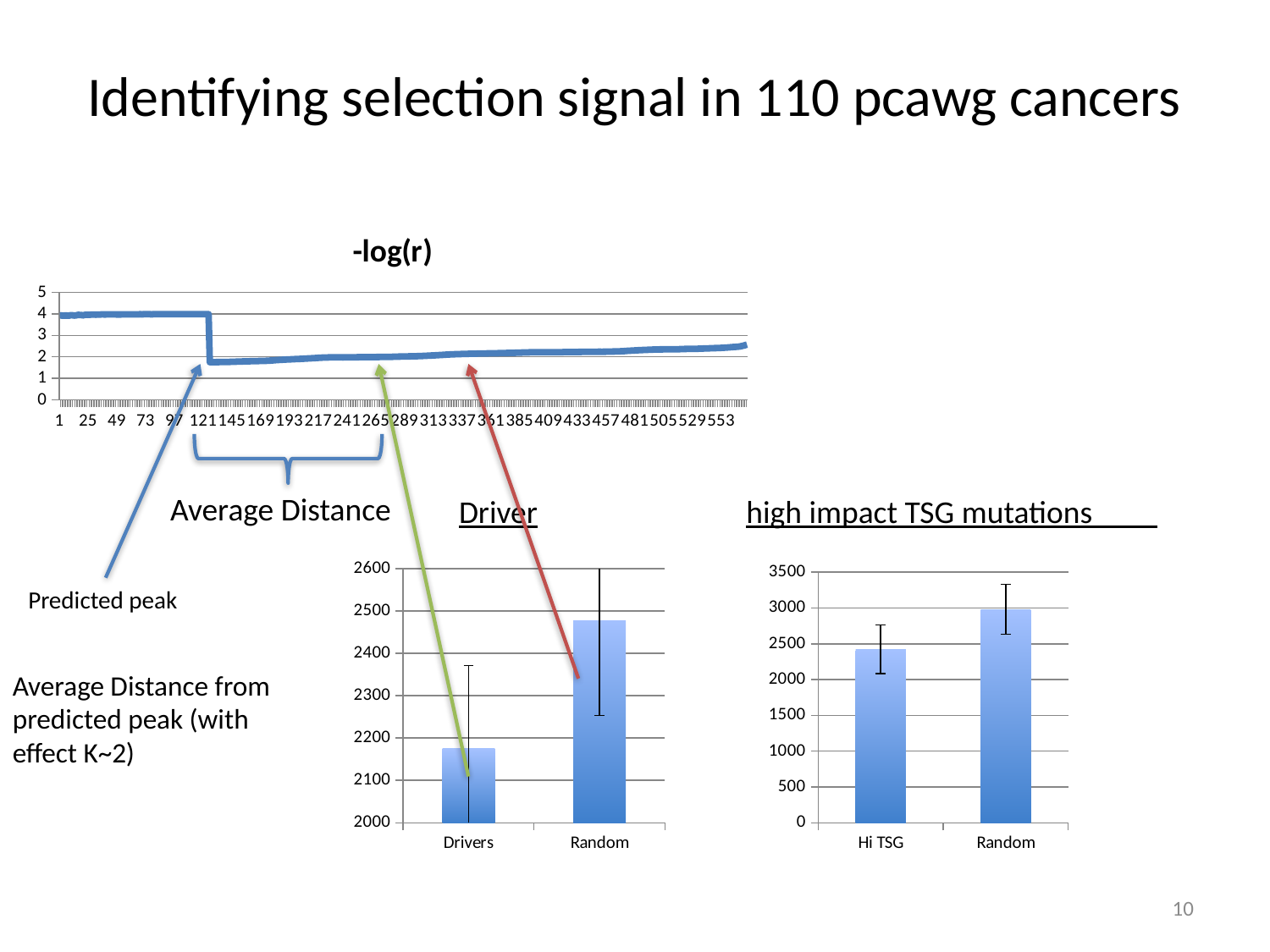
What kind of chart is the chart titled "-log(r)"? line chart In the "Driver" chart, is the value for Drivers greater or less than 2200? less What kind of chart is the "high impact TSG mutations" chart? bar chart What kind of chart is the "Driver" chart? bar chart In the "Driver" chart, how many categories are shown on the x axis? 2 In the "-log(r)" line chart, is the value at x = 1 greater or less than 3? greater In the "high impact TSG mutations" chart, what are the two categories on the x axis? Hi TSG and Random In the "Driver" chart, is the value for Random greater or less than 2400? greater In the "Driver" chart, which category has the higher bar? Random In the "Driver" chart, which category has the lower bar? Drivers In the "high impact TSG mutations" chart, which category has the higher bar? Random